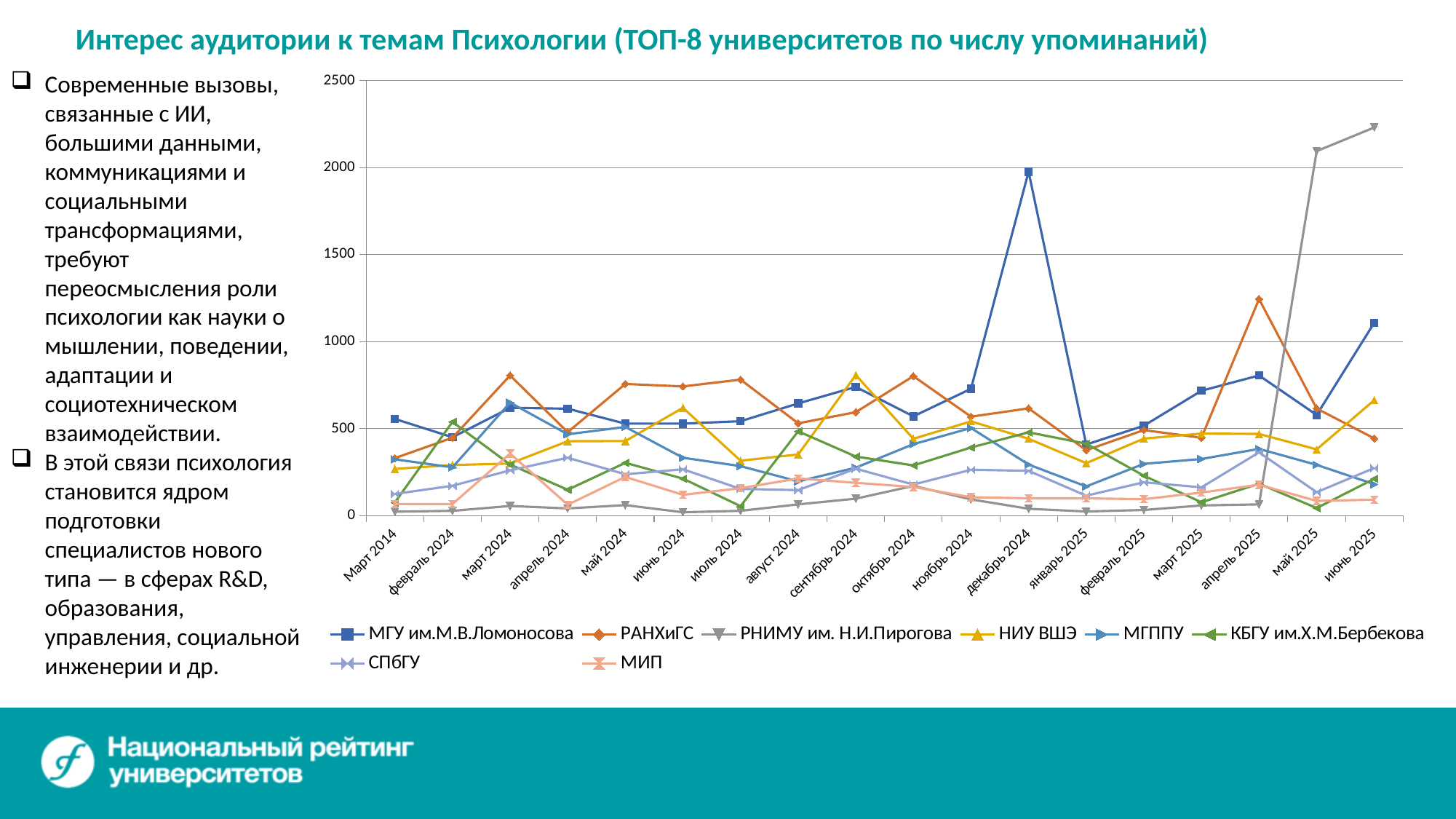
Is the value for МГУ им.М.В.Ломоносова in декабрь 2024 greater or less than 1500? greater In апрель 2025, which is larger: РАНХиГС or МГУ им.М.В.Ломоносова? РАНХиГС Which series reaches the highest value anywhere on the chart? РНИМУ им. Н.И.Пирогова In декабрь 2024, which is larger: МГУ им.М.В.Ломоносова or РАНХиГС? МГУ им.М.В.Ломоносова What kind of chart is shown on the slide? line chart In which month does МГУ им.М.В.Ломоносова reach its highest value? декабрь 2024 Is the value for РНИМУ им. Н.И.Пирогова in январь 2025 greater or less than 500? less What is the title of the chart on the slide? Интерес аудитории к темам Психологии (ТОП-8 университетов по числу упоминаний) How many time points are shown along the x axis? 18 Is the value for РНИМУ им. Н.И.Пирогова in июнь 2025 greater or less than 2000? greater How many series does the legend list? 8